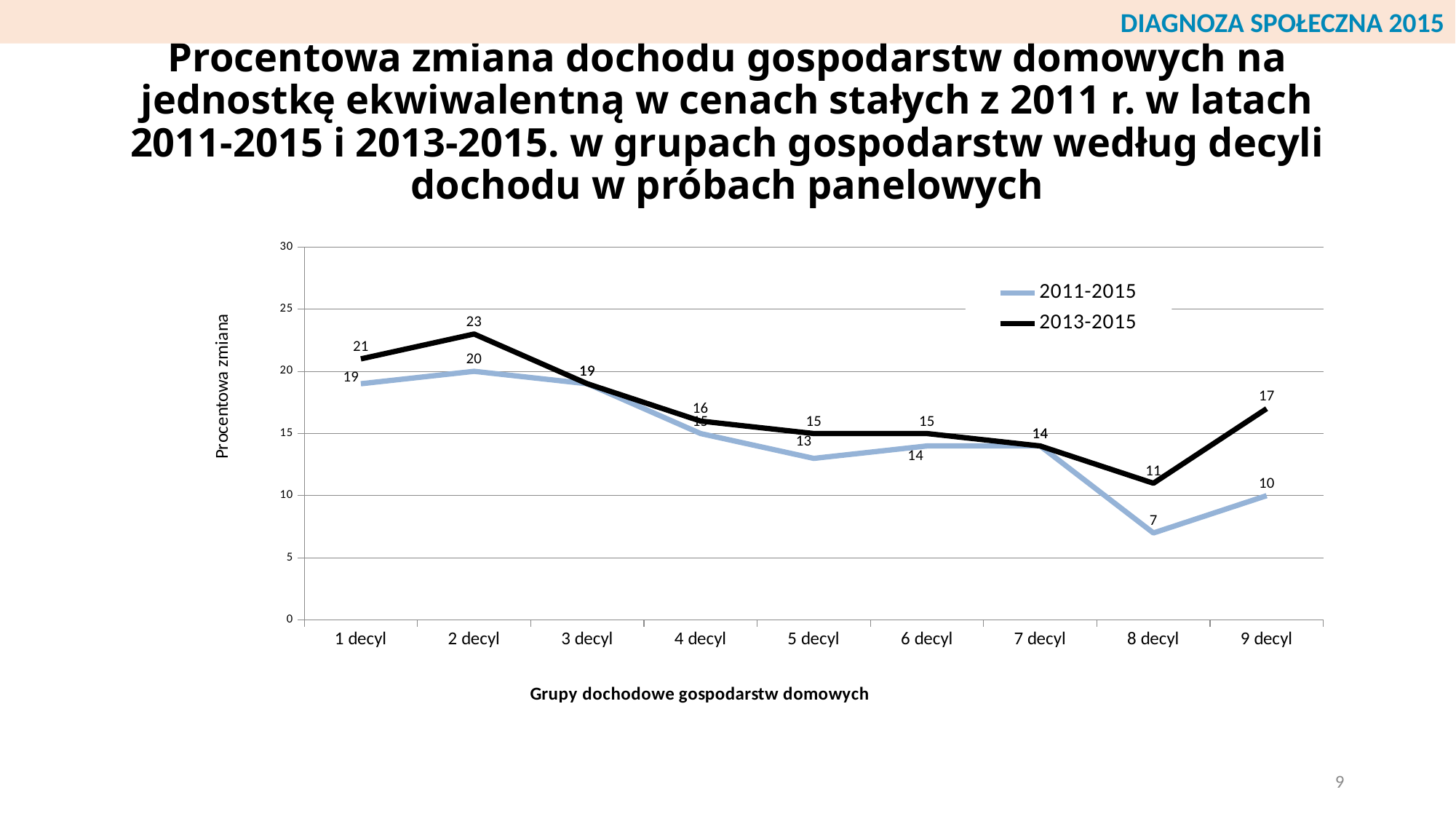
What is the label of the x axis? Grupy dochodowe gospodarstw domowych How many series does the legend list? 2 What is the value for 8 decyl in the 2011-2015 series? 7 What is the value for 9 decyl in the 2013-2015 series? 17 Which decile has the lowest value in the 2011-2015 series? 8 decyl Which decile has the highest value in the 2013-2015 series? 2 decyl What is the difference between the 2013-2015 and 2011-2015 values for 9 decyl? 7 What is the value for 2 decyl in the 2013-2015 series? 23 For 5 decyl, which series has the larger value, 2011-2015 or 2013-2015? 2013-2015 How many decile groups are shown on the x axis? 9 Does the 2011-2015 series rise or fall from 2 decyl to 8 decyl? Fall What kind of chart is shown on the slide? Line chart